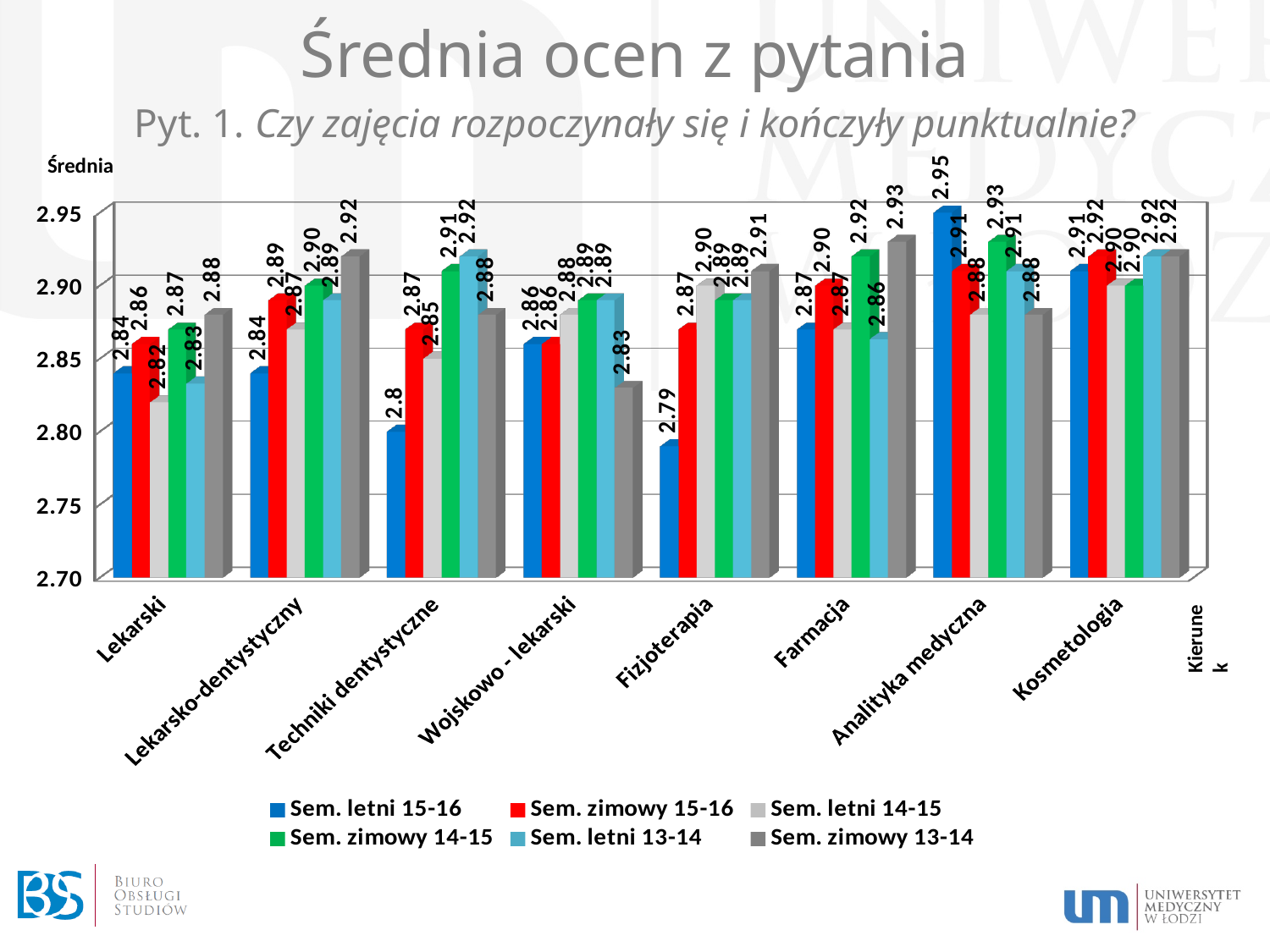
What is the label on the vertical axis of the chart? Średnia What kind of chart is shown on the slide? bar chart Which category has the lowest value for Sem. letni 15-16? Fizjoterapia For Sem. letni 15-16, which is larger: Lekarski or Kosmetologia? Kosmetologia Which category has the highest value for Sem. letni 15-16? Analityka medyczna How many categories (kierunki) are shown on the x axis of the chart? 8 What is the difference between the Sem. letni 15-16 values for Analityka medyczna and Fizjoterapia? 0.16 How many series does the legend of the chart list? 6 What is the value for Sem. letni 15-16 for Techniki dentystyczne? 2.8 What is the value for Sem. letni 15-16 for Fizjoterapia? 2.79 What is the value for Sem. letni 15-16 for Analityka medyczna? 2.95 Is the Sem. letni 15-16 value for Fizjoterapia greater or less than 2.80? less